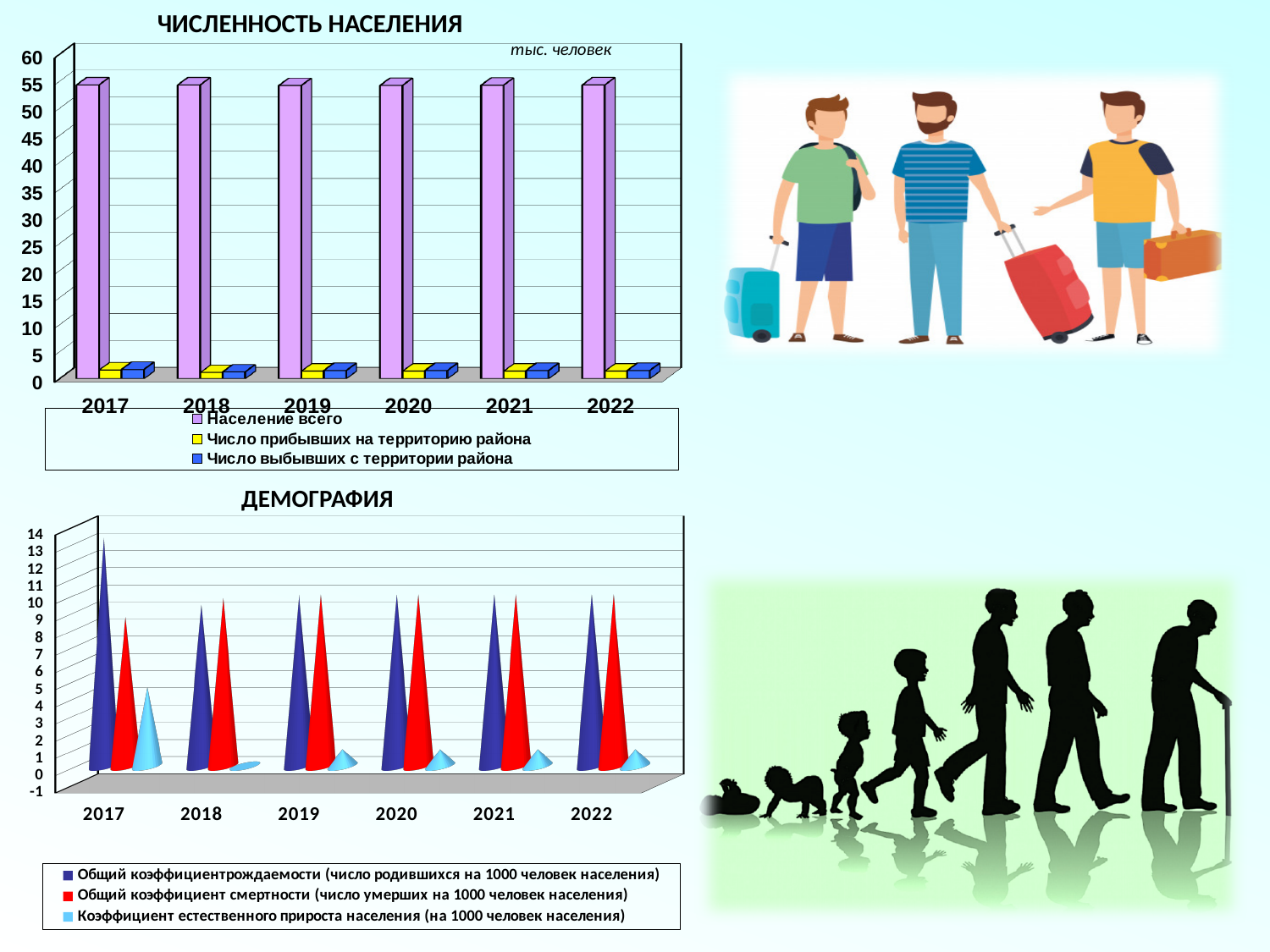
On the chart titled ЧИСЛЕННОСТЬ НАСЕЛЕНИЯ, what unit is stated at the top of the plot area? тыс. человек On the chart titled ДЕМОГРАФИЯ, how many series does the legend list? 3 On the chart titled ДЕМОГРАФИЯ, which year has the highest value for Общий коэффициент рождаемости? 2017 On the chart titled ДЕМОГРАФИЯ, is the value for Коэффициент естественного прироста населения in 2017 greater or less than 3? greater On the chart titled ДЕМОГРАФИЯ, is the value for Общий коэффициент рождаемости in 2017 greater or less than 10? greater On the chart titled ЧИСЛЕННОСТЬ НАСЕЛЕНИЯ, is the value for Число прибывших на территорию района in 2020 greater or less than 5? less On the chart titled ЧИСЛЕННОСТЬ НАСЕЛЕНИЯ, how many years are shown on the x axis? 6 On the chart titled ЧИСЛЕННОСТЬ НАСЕЛЕНИЯ, how many series does the legend list? 3 On the chart titled ДЕМОГРАФИЯ, which is larger: Коэффициент естественного прироста населения in 2017 or in 2018? 2017 On the chart titled ЧИСЛЕННОСТЬ НАСЕЛЕНИЯ, what kind of chart is it? bar chart On the chart titled ДЕМОГРАФИЯ, in 2017, which is larger: Общий коэффициент рождаемости or Общий коэффициент смертности? Общий коэффициент рождаемости